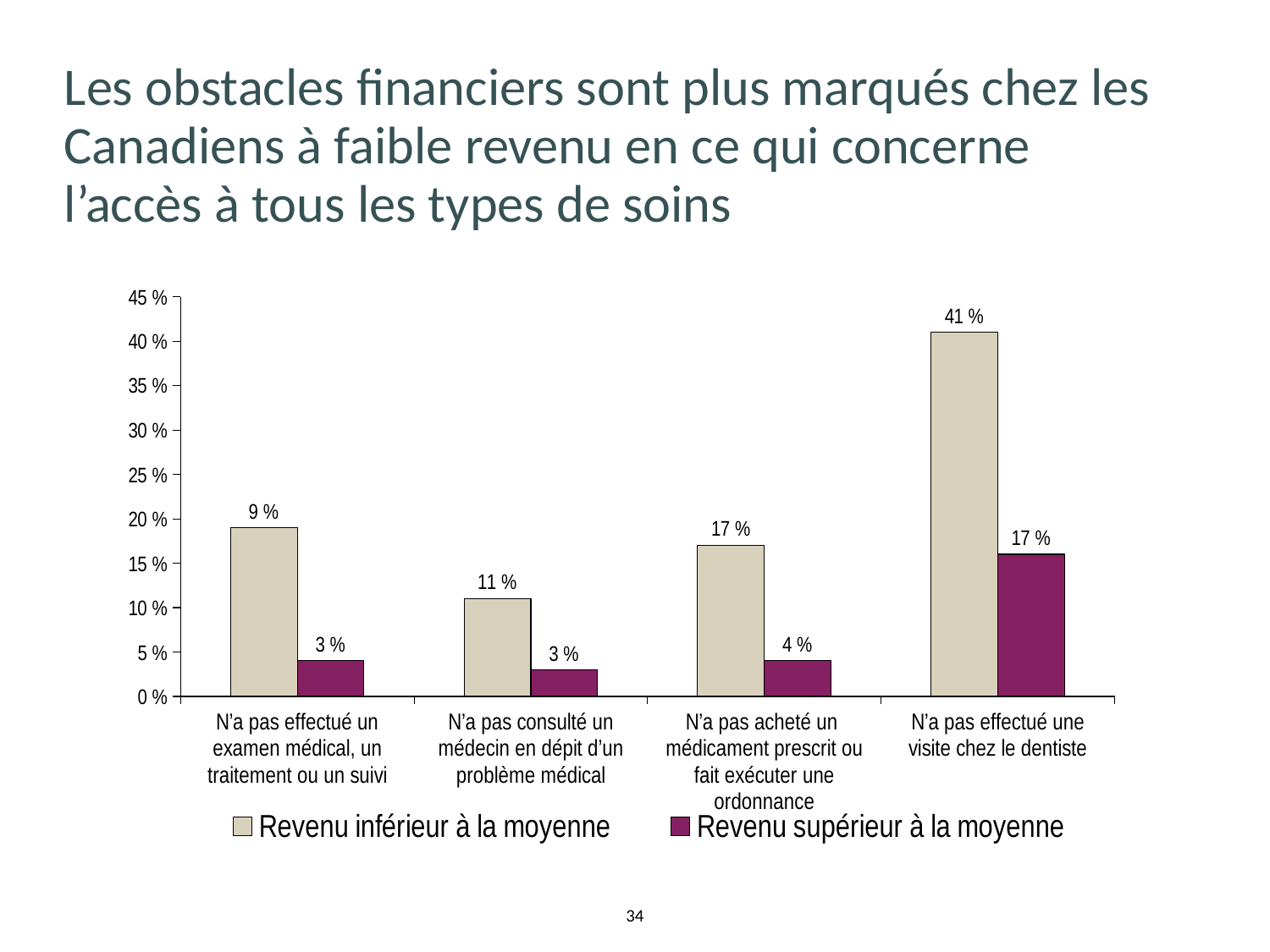
What is the value for "Revenu supérieur à la moyenne" in the category "N'a pas consulté un médecin en dépit d'un problème médical"? 3 % In the category "N'a pas acheté un médicament prescrit ou fait exécuter une ordonnance", what is the difference between the "Revenu inférieur à la moyenne" and "Revenu supérieur à la moyenne" values? 13 % Is the value for "Revenu inférieur à la moyenne" in "N'a pas effectué une visite chez le dentiste" greater or less than 40 %? greater How many series does the legend list? 2 What is the value for "Revenu inférieur à la moyenne" in the category "N'a pas consulté un médecin en dépit d'un problème médical"? 11 % What is the difference between the "Revenu inférieur à la moyenne" values for "N'a pas effectué une visite chez le dentiste" and "N'a pas acheté un médicament prescrit ou fait exécuter une ordonnance"? 24 % What kind of chart is shown on the slide? bar chart Which category has the highest value for "Revenu inférieur à la moyenne"? N'a pas effectué une visite chez le dentiste What is the value for "Revenu inférieur à la moyenne" in the category "N'a pas effectué une visite chez le dentiste"? 41 % How many categories are shown on the x axis of the chart? 4 For "Revenu inférieur à la moyenne", which is larger: "N'a pas effectué une visite chez le dentiste" or "N'a pas acheté un médicament prescrit ou fait exécuter une ordonnance"? N'a pas effectué une visite chez le dentiste What is the value for "Revenu supérieur à la moyenne" in the category "N'a pas acheté un médicament prescrit ou fait exécuter une ordonnance"? 4 %